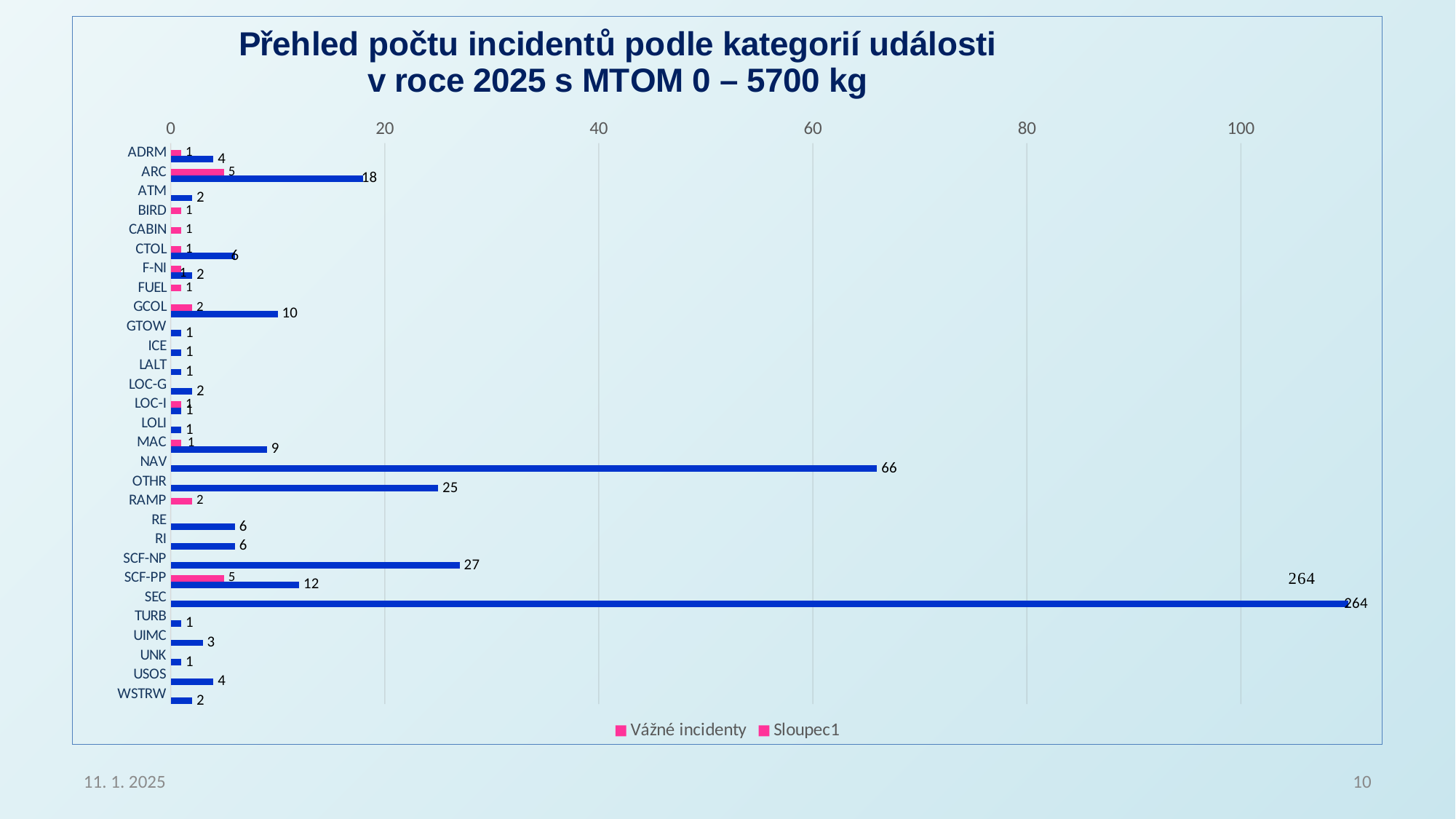
What kind of chart is shown on the slide? bar chart What is the blue bar value for OTHR? 25 Which category has the highest blue bar value? SEC What is the difference between the blue bar values for NAV and OTHR? 41 What is the pink (Vážné incidenty) value for ARC? 5 What is the blue bar value for SCF-NP? 27 What is the title of the chart? Přehled počtu incidentů podle kategorií události v roce 2025 s MTOM 0 – 5700 kg How many categories are listed on the vertical axis? 29 What is the blue bar value for NAV? 66 How many series does the legend list? 2 Which has the larger blue bar value, ARC or GCOL? ARC Is the blue bar value for SEC greater or less than 100? greater